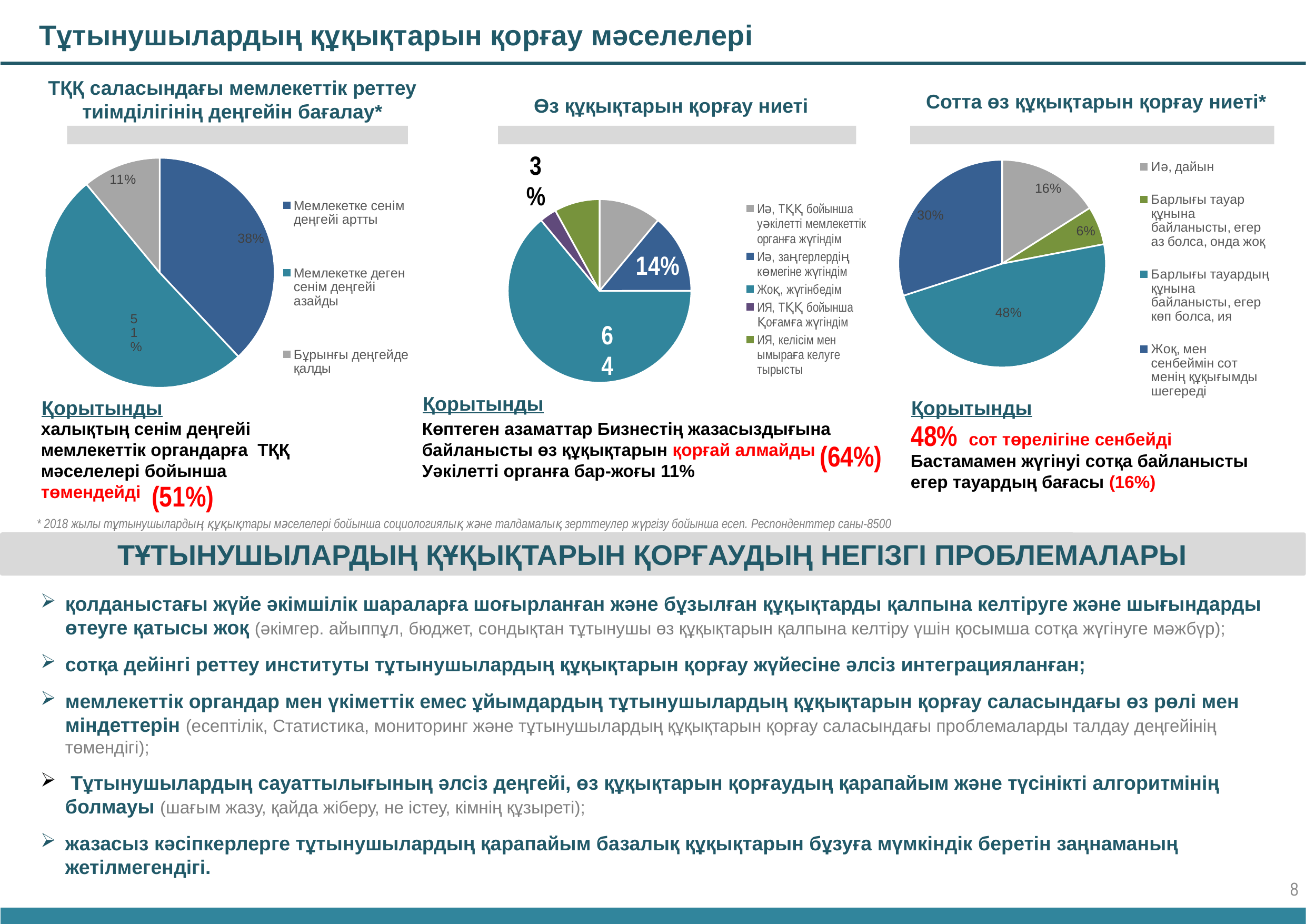
In the right chart 'Сотта өз құқықтарын қорғау ниеті', what share is 'Жоқ, мен сенбеймін сот менің құқығымды шегереді'? 30% In the left chart 'ТҚҚ саласындағы мемлекеттік реттеу тиімділігінің деңгейін бағалау', what share is 'Мемлекетке деген сенім деңгейі азайды'? 51% In the middle chart 'Өз құқықтарын қорғау ниеті', which category has the largest slice? Жоқ, жүгінбедім What kind of chart is the right chart 'Сотта өз құқықтарын қорғау ниеті'? Pie chart In the left chart 'ТҚҚ саласындағы мемлекеттік реттеу тиімділігінің деңгейін бағалау', how many categories does the legend list? 3 In the left chart 'ТҚҚ саласындағы мемлекеттік реттеу тиімділігінің деңгейін бағалау', what is the difference between 'Мемлекетке деген сенім деңгейі азайды' and 'Мемлекетке сенім деңгейі артты'? 13% In the middle chart 'Өз құқықтарын қорғау ниеті', how many categories does the legend list? 5 In the right chart 'Сотта өз құқықтарын қорғау ниеті', which category has the largest slice? Барлығы тауардың құнына байланысты, егер көп болса, ия In the middle chart 'Өз құқықтарын қорғау ниеті', what share is 'Иә, заңгерлердің көмегіне жүгіндім'? 14% In the right chart 'Сотта өз құқықтарын қорғау ниеті', what share is 'Иә, дайын'? 16% In the left chart 'ТҚҚ саласындағы мемлекеттік реттеу тиімділігінің деңгейін бағалау', what share is 'Мемлекетке сенім деңгейі артты'? 38% In the left chart 'ТҚҚ саласындағы мемлекеттік реттеу тиімділігінің деңгейін бағалау', which category has the smallest slice? Бұрынғы деңгейде қалды